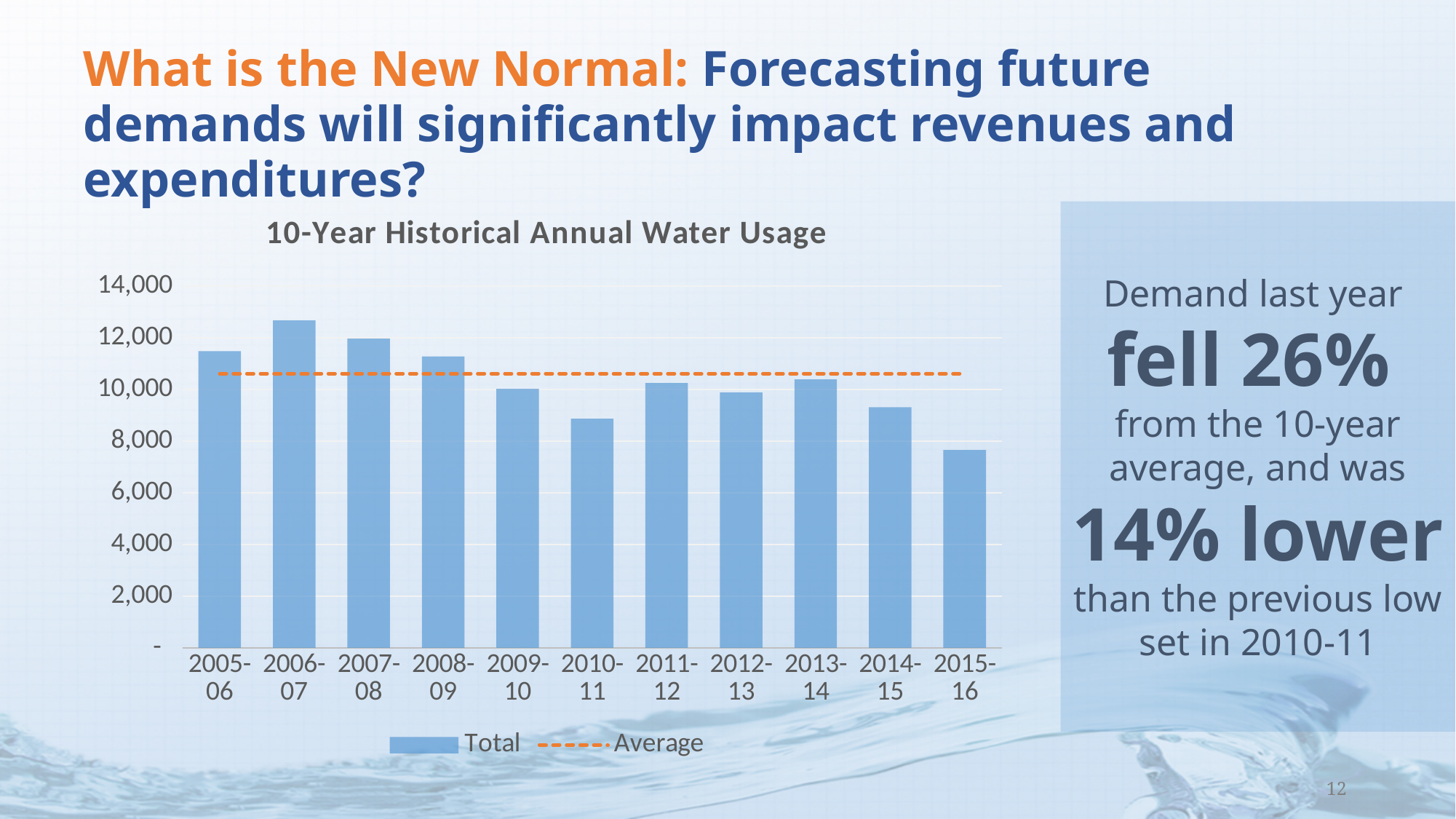
What is the title of the chart? 10-Year Historical Annual Water Usage Is the total water usage for 2006-07 greater or less than 12,000? greater Overall, do the total water usage values rise or fall from 2005-06 to 2015-16? Fall Which year has the lowest total water usage? 2015-16 Which series is drawn as an orange dashed line in the chart? Average How many fiscal years are shown on the x axis of the chart? 11 Which year has higher total water usage, 2007-08 or 2008-09? 2007-08 What kind of chart is shown on the slide? Bar chart How many series does the chart legend list? 2 Which year has the highest total water usage? 2006-07 Is the total water usage for 2015-16 greater or less than 8,000? less Is the total water usage for 2010-11 greater or less than 10,000? less